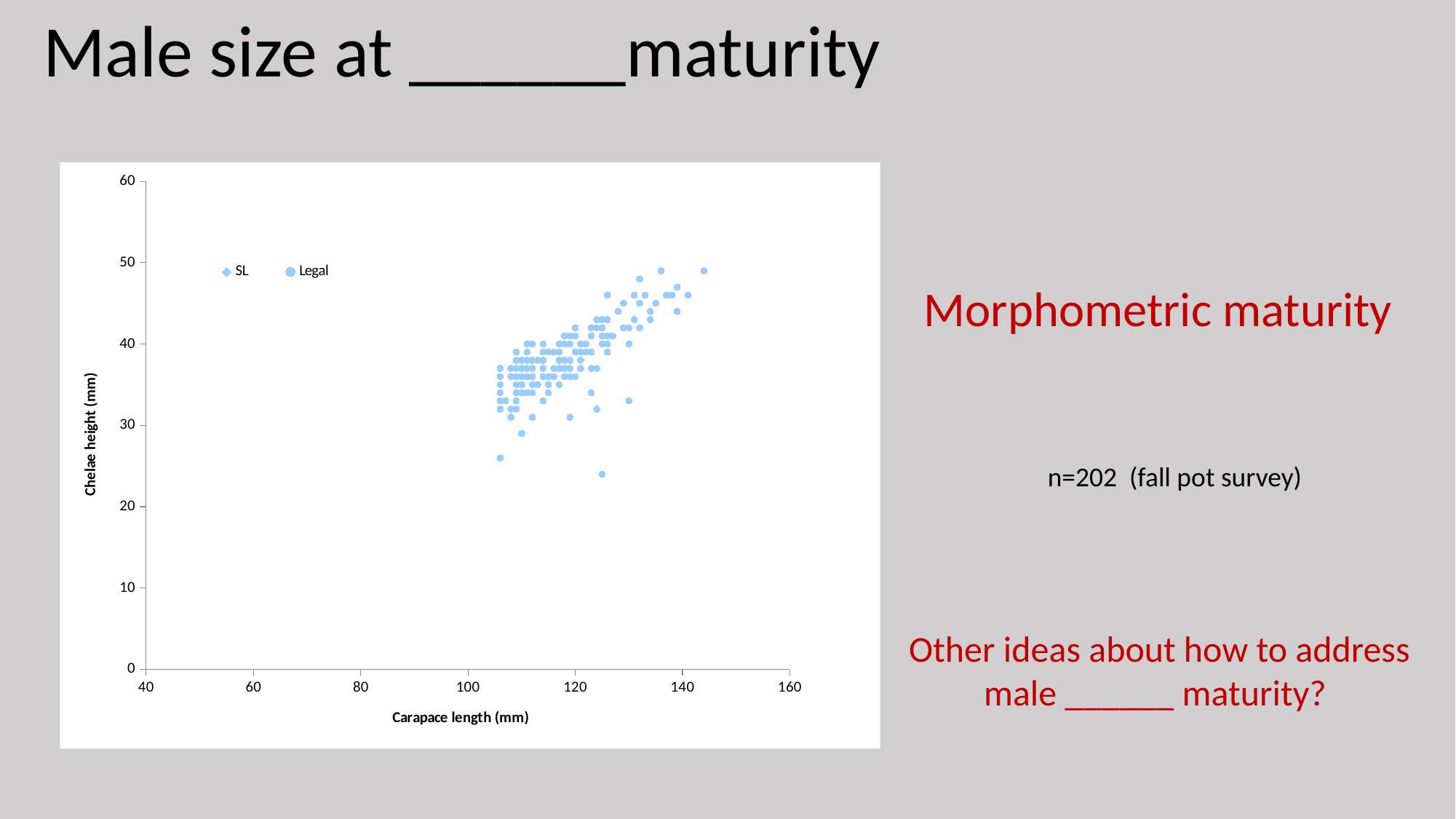
Is the lowest chelae height plotted greater or less than 30? less As carapace length increases along the x axis, does chelae height generally rise or fall? rise What are the two series named in the chart's legend? SL and Legal How many series does the chart's legend list? 2 What kind of chart is shown on the slide? scatter plot Is the smallest carapace length plotted greater or less than 100? greater What is the label of the chart's x axis? Carapace length (mm) Is the largest chelae height plotted greater or less than 50? less